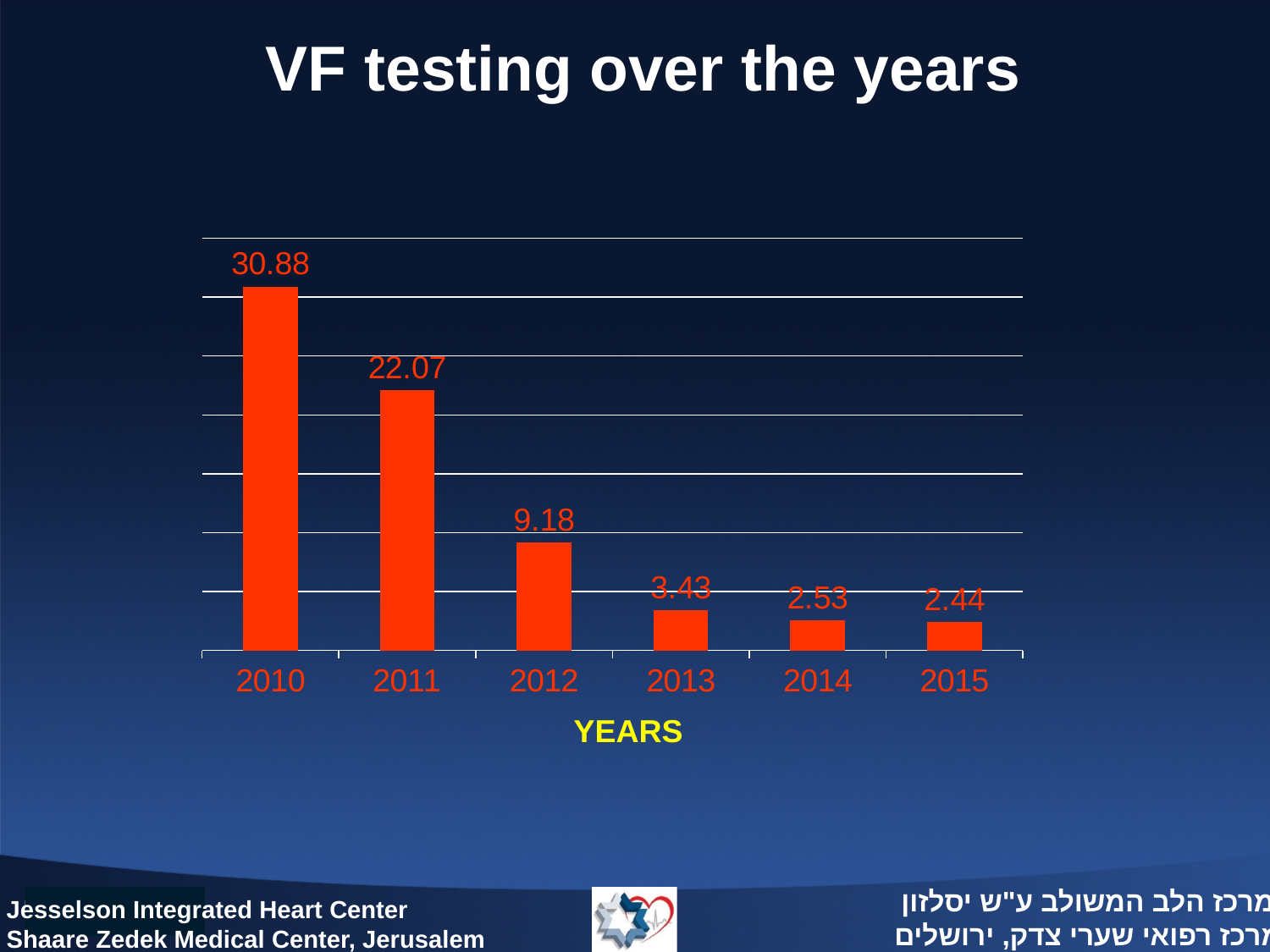
What kind of chart is shown on the slide? Bar chart Which is larger, the value for 2011 or the value for 2012? 2011 Which year has the lowest value? 2015 Do the values rise or fall from 2010 to 2015? Fall What is the value for 2010? 30.88 What is the value for 2015? 2.44 Which year has the highest value? 2010 What is the title of the x axis? YEARS How many years are shown on the x axis? 6 What is the value for 2012? 9.18 What is the difference between the values for 2012 and 2013? 5.75 What is the difference between the values for 2010 and 2011? 8.81